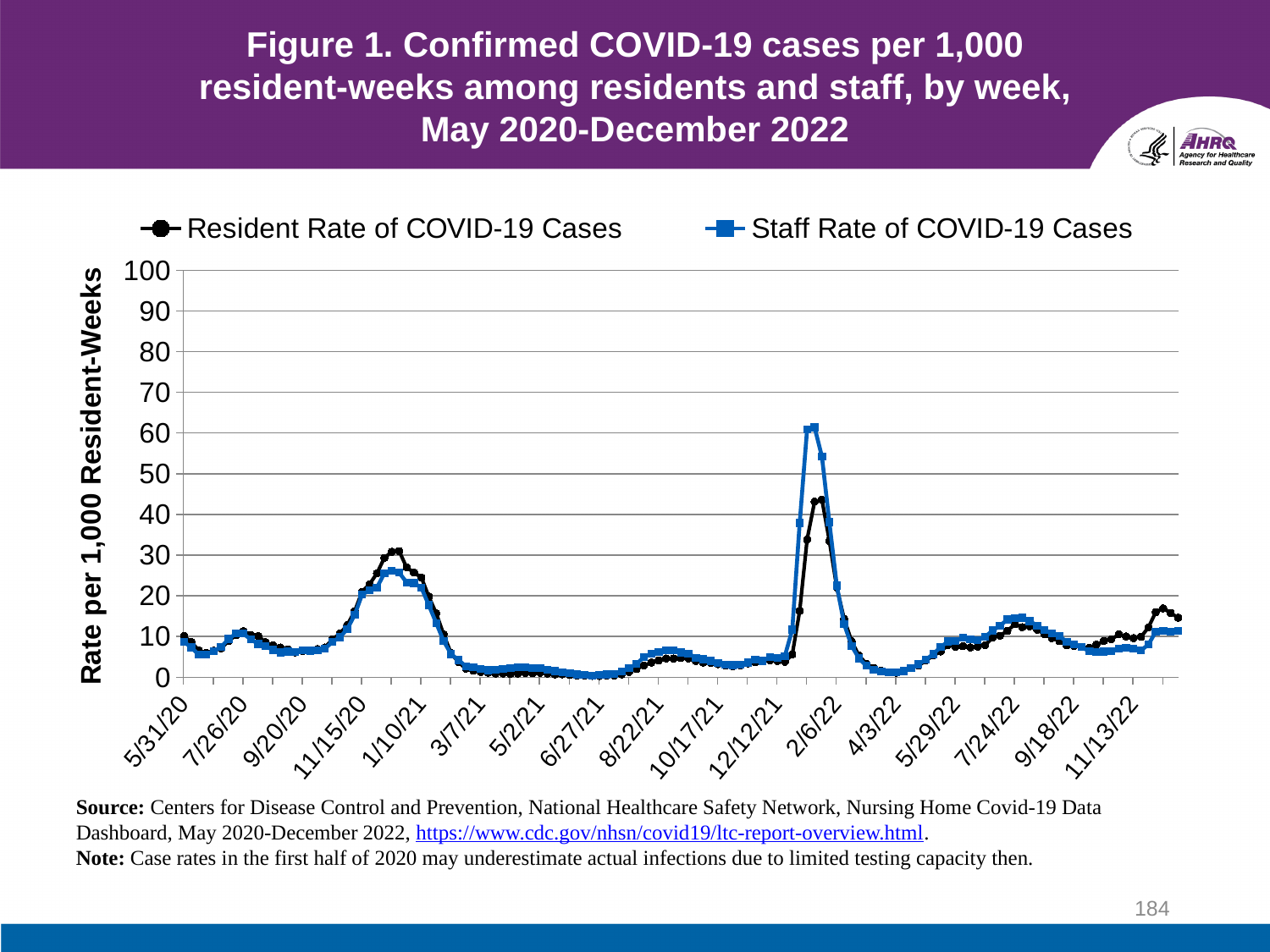
At the peak in early 2022 (around 2/6/22), which series is higher, the resident rate or the staff rate? Staff Rate of COVID-19 Cases Is the peak value of the Resident Rate of COVID-19 Cases in early 2022 greater or less than 30? greater Is the Resident Rate of COVID-19 Cases around 5/2/21 greater or less than 10? less What kind of chart is shown on the slide? Line chart Do the case rates rise or fall between 2/6/22 and 4/3/22? fall What are the two series named in the legend? Resident Rate of COVID-19 Cases and Staff Rate of COVID-19 Cases At the peak around 1/10/21, which series is higher, the resident rate or the staff rate? Resident Rate of COVID-19 Cases Is the peak value of the Staff Rate of COVID-19 Cases in early 2022 greater or less than 50? greater What is the label on the vertical axis? Rate per 1,000 Resident-Weeks How many series does the legend list? 2 Which series reaches the highest value anywhere on the chart? Staff Rate of COVID-19 Cases